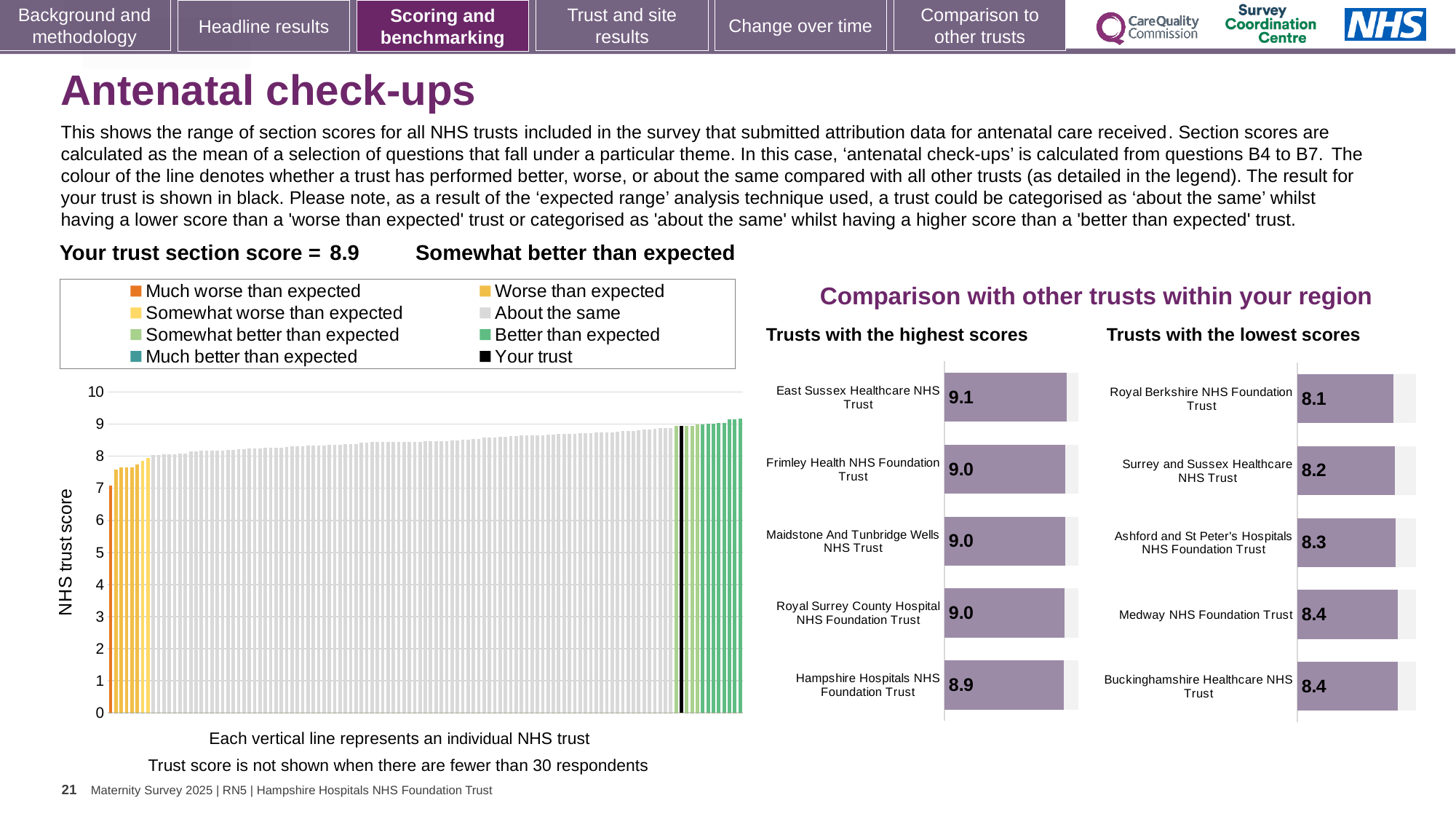
How many entries does the legend of the 'NHS trust score' chart list? 8 In the 'Trusts with the lowest scores' chart, what is the difference between the scores of Buckinghamshire Healthcare NHS Trust and Royal Berkshire NHS Foundation Trust? 0.3 In the 'Trusts with the lowest scores' chart, which trust has the lowest score? Royal Berkshire NHS Foundation Trust In the 'Trusts with the lowest scores' chart, what is the score for Royal Berkshire NHS Foundation Trust? 8.1 What kind of chart is the 'NHS trust score' chart on the left? Bar chart In the 'Trusts with the highest scores' chart, what is the score for Hampshire Hospitals NHS Foundation Trust? 8.9 In the 'NHS trust score' chart on the left, is the value of the leftmost bar greater or less than 8? less In the 'Trusts with the highest scores' chart, what is the difference between the scores of East Sussex Healthcare NHS Trust and Hampshire Hospitals NHS Foundation Trust? 0.2 In the 'Trusts with the highest scores' chart, which trust has the highest score? East Sussex Healthcare NHS Trust In the 'Trusts with the lowest scores' chart, which has the higher score: Ashford and St Peter's Hospitals NHS Foundation Trust or Surrey and Sussex Healthcare NHS Trust? Ashford and St Peter's Hospitals NHS Foundation Trust How many trusts are shown in the 'Trusts with the highest scores' chart? 5 In the 'Trusts with the highest scores' chart, what is the score for East Sussex Healthcare NHS Trust? 9.1